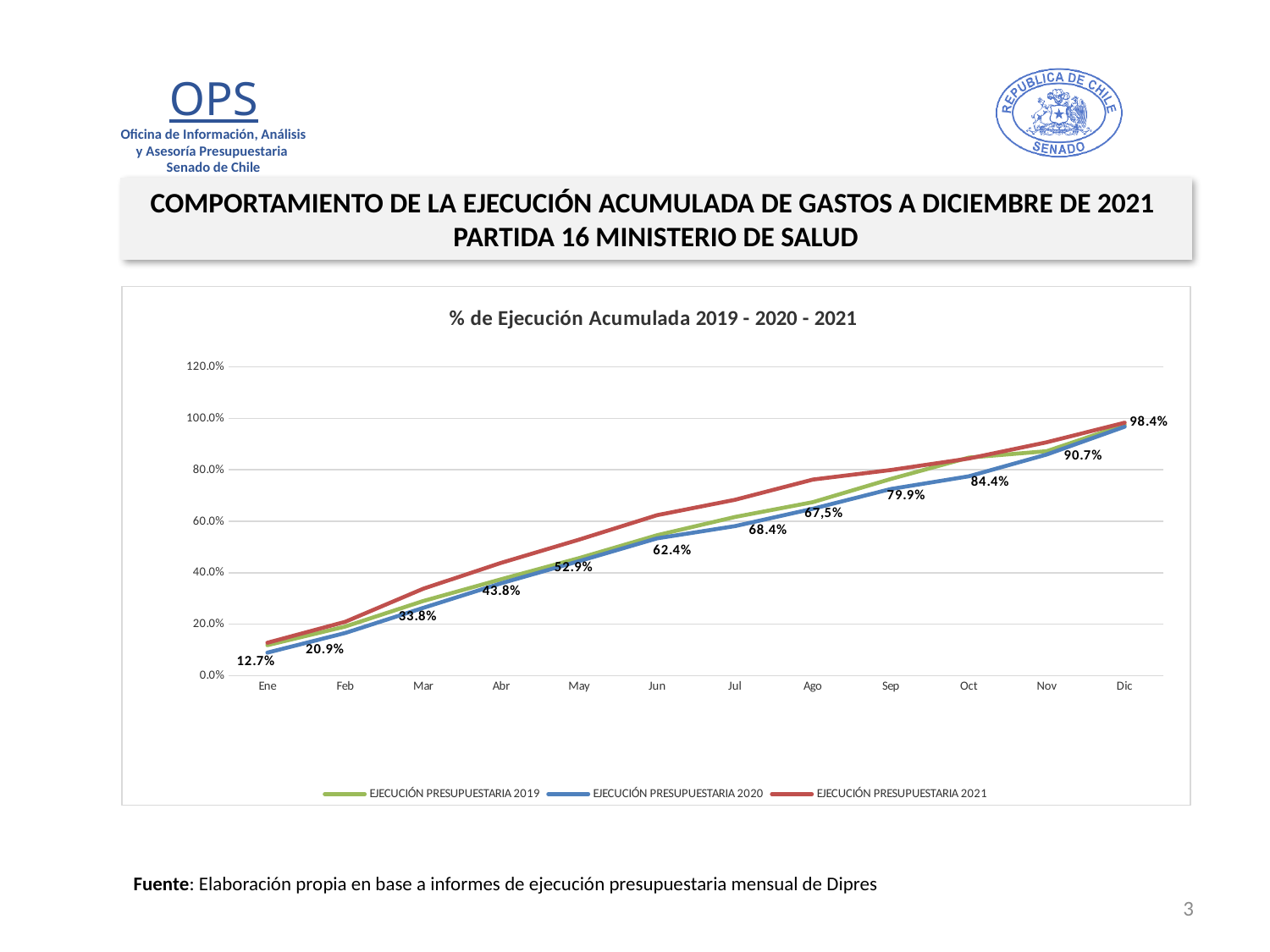
How many series does the legend of the chart list? 3 What value is labelled at Jun on the chart? 62.4% What value is labelled at Dic on the chart? 98.4% How many months are plotted along the x axis of the chart? 12 What is the difference between the value labelled at Dic and the value labelled at Ene? 85.7 percentage points At Ago, which series is higher: EJECUCIÓN PRESUPUESTARIA 2021 or EJECUCIÓN PRESUPUESTARIA 2020? EJECUCIÓN PRESUPUESTARIA 2021 What type of chart is shown on the slide? Line chart Is the value for EJECUCIÓN PRESUPUESTARIA 2020 at Ene greater or less than 20.0%? less Is the value for EJECUCIÓN PRESUPUESTARIA 2021 at Ago greater or less than 60.0%? greater What value is labelled at Ene on the chart? 12.7% Do the plotted lines generally rise or fall from Ene to Dic? Rise What is the title of the chart? % de Ejecución Acumulada 2019 - 2020 - 2021